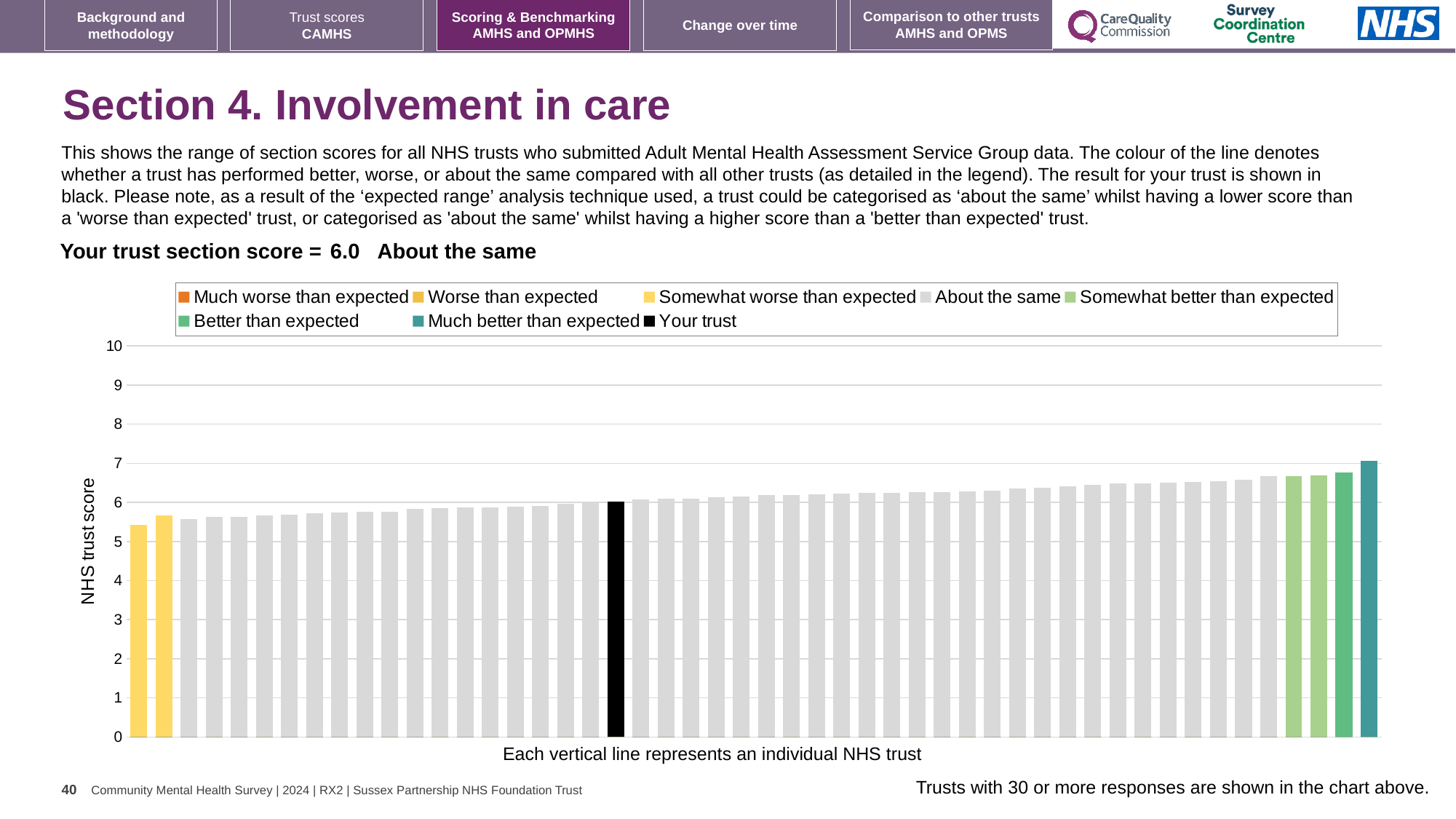
Is the leftmost bar larger or smaller than the bar for your trust? smaller What is the title of the vertical axis? NHS trust score Is the value of the tallest bar greater or less than 6? greater What is the section score for your trust? 6.0 Do the bar values rise or fall from left to right across the chart? rise Is the value for your trust greater or less than 5? greater Is the value of the leftmost bar greater or less than 6? less Which legend category does the tallest bar belong to? Much better than expected How many bars are coloured as 'Worse than expected'? 0 How many entries does the chart legend list? 8 Which legend category does the shortest bar belong to? Somewhat worse than expected What type of chart is shown on the slide? bar chart